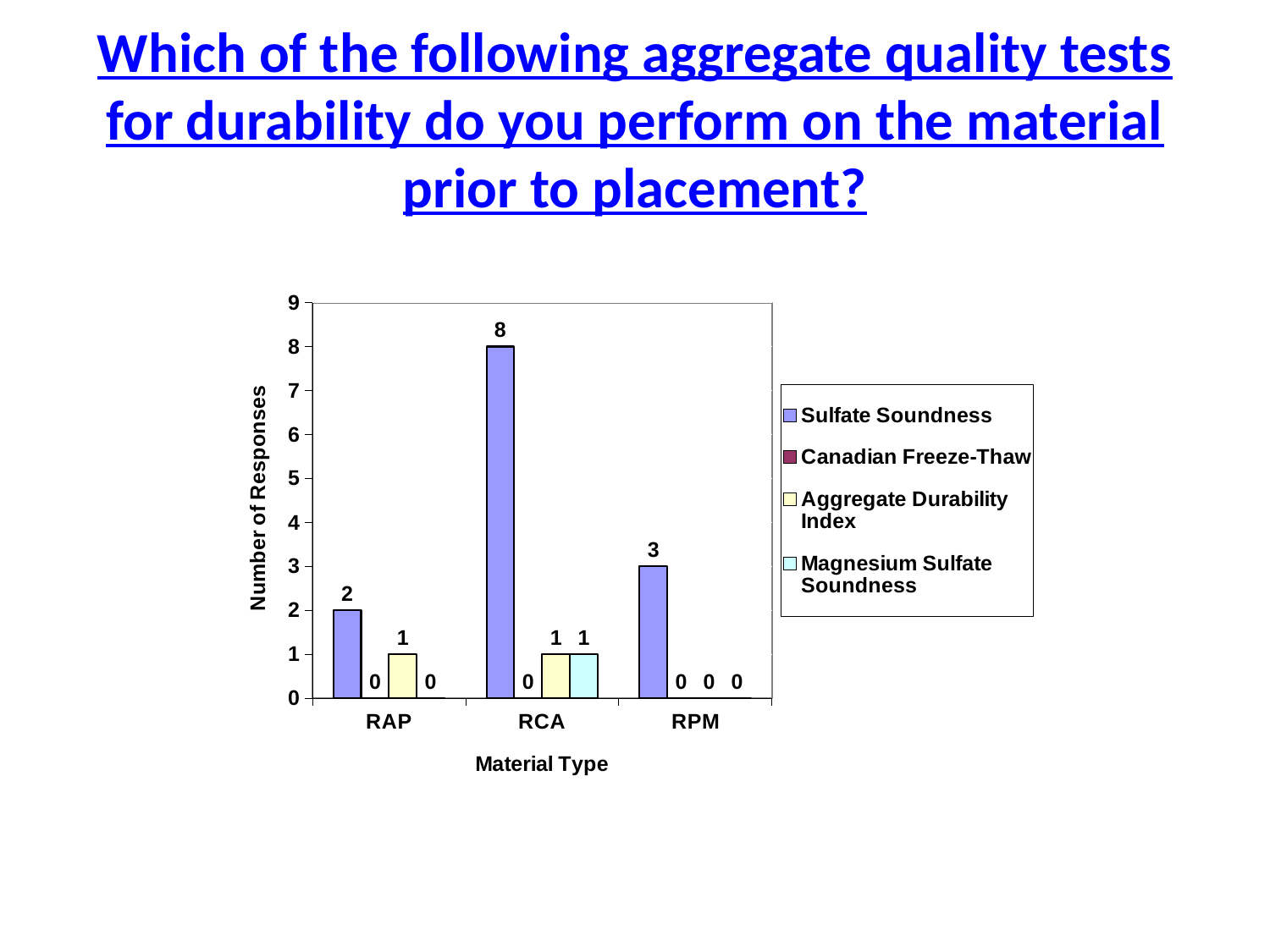
Which material type has the highest number of responses for Sulfate Soundness? RCA Which is larger: the Sulfate Soundness responses for RAP or for RPM? RPM What is the label of the y axis? Number of Responses Which material type has the lowest number of responses for Sulfate Soundness? RAP What is the number of responses for Aggregate Durability Index for RAP? 1 What is the number of responses for Sulfate Soundness for RCA? 8 How many series does the legend list? 4 What is the number of responses for Sulfate Soundness for RPM? 3 What is the number of responses for Magnesium Sulfate Soundness for RCA? 1 What kind of chart is shown on the slide? Bar chart How many material types are shown on the x axis? 3 What is the difference between the Sulfate Soundness responses for RCA and RPM? 5